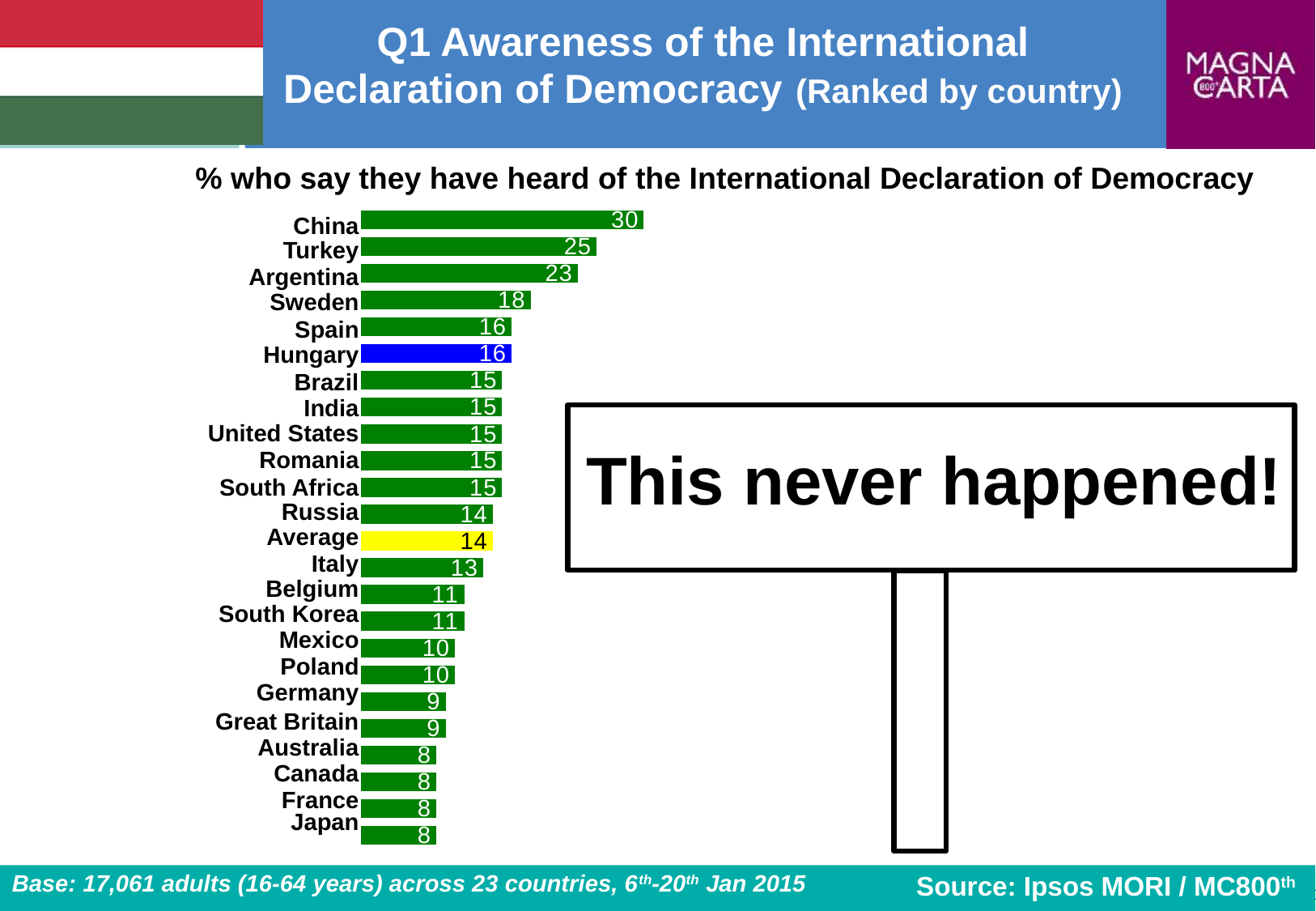
What is the difference between the values for China and Turkey? 5 What is the difference between the values for Hungary and the Average? 2 Which country has the highest value? China Which has a larger value, Argentina or Russia? Argentina What is the value for China? 30 How many bars are plotted in the chart? 24 Which bar is coloured blue? Hungary What kind of chart is shown on the slide? Bar chart What is the value for Japan? 8 What is the value for Hungary? 16 Which has a larger value, Sweden or Italy? Sweden What is the value shown for Average? 14